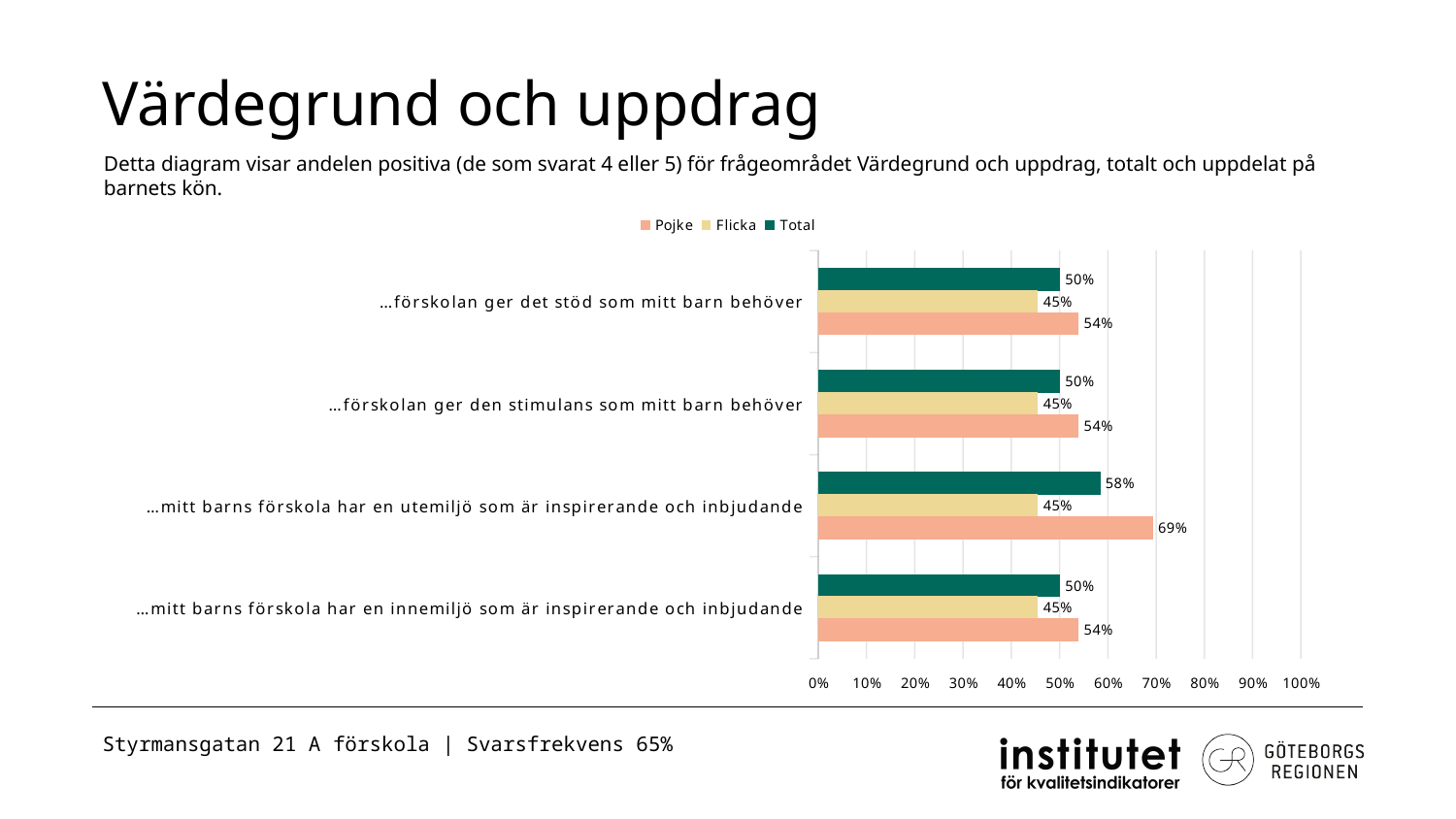
What is the difference between the Pojke and Flicka values for "…mitt barns förskola har en utemiljö som är inspirerande och inbjudande"? 24 percentage points What is the Pojke value for "…förskolan ger det stöd som mitt barn behöver"? 54% What is the Flicka value for "…mitt barns förskola har en innemiljö som är inspirerande och inbjudande"? 45% What is the Pojke value for "…mitt barns förskola har en utemiljö som är inspirerande och inbjudande"? 69% Which series is shown in dark green in the legend? Total Which category has the highest Total value? …mitt barns förskola har en utemiljö som är inspirerande och inbjudande For "…förskolan ger den stimulans som mitt barn behöver", which is larger: the Pojke value or the Flicka value? Pojke What is the difference between the Total values for "…mitt barns förskola har en utemiljö som är inspirerande och inbjudande" and "…förskolan ger det stöd som mitt barn behöver"? 8 percentage points How many categories (statements) are shown in the chart? 4 What kind of chart is shown on the slide? Bar chart What is the Total value for "…förskolan ger det stöd som mitt barn behöver"? 50% How many series does the legend list? 3